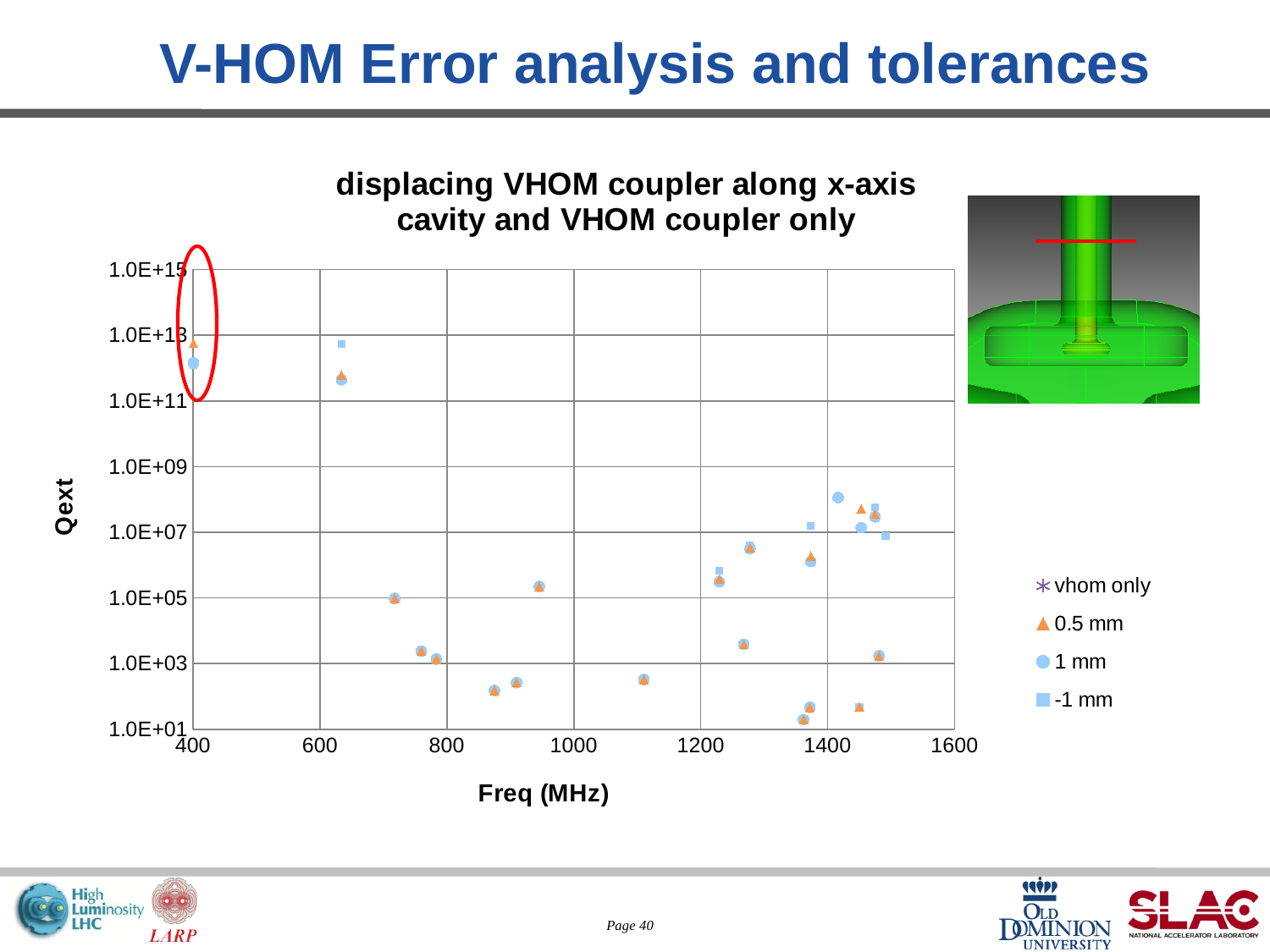
What is the label of the x-axis of the chart? Freq (MHz) What kind of chart is shown on the slide? scatter chart What is the highest value shown on the y-axis of the chart? 1.0E+15 Is the Qext value of the points near 880 MHz greater or less than 1.0E+03? less Is the Qext value of the 1 mm point near 1410 MHz greater or less than 1.0E+07? greater Which is larger: the Qext value of the points near 720 MHz or the Qext value of the points near 1110 MHz? near 720 MHz What is the label of the y-axis of the chart? Qext Is the Qext value of the 0.5 mm point near 400 MHz greater or less than 1.0E+11? greater How many series does the chart legend list? 4